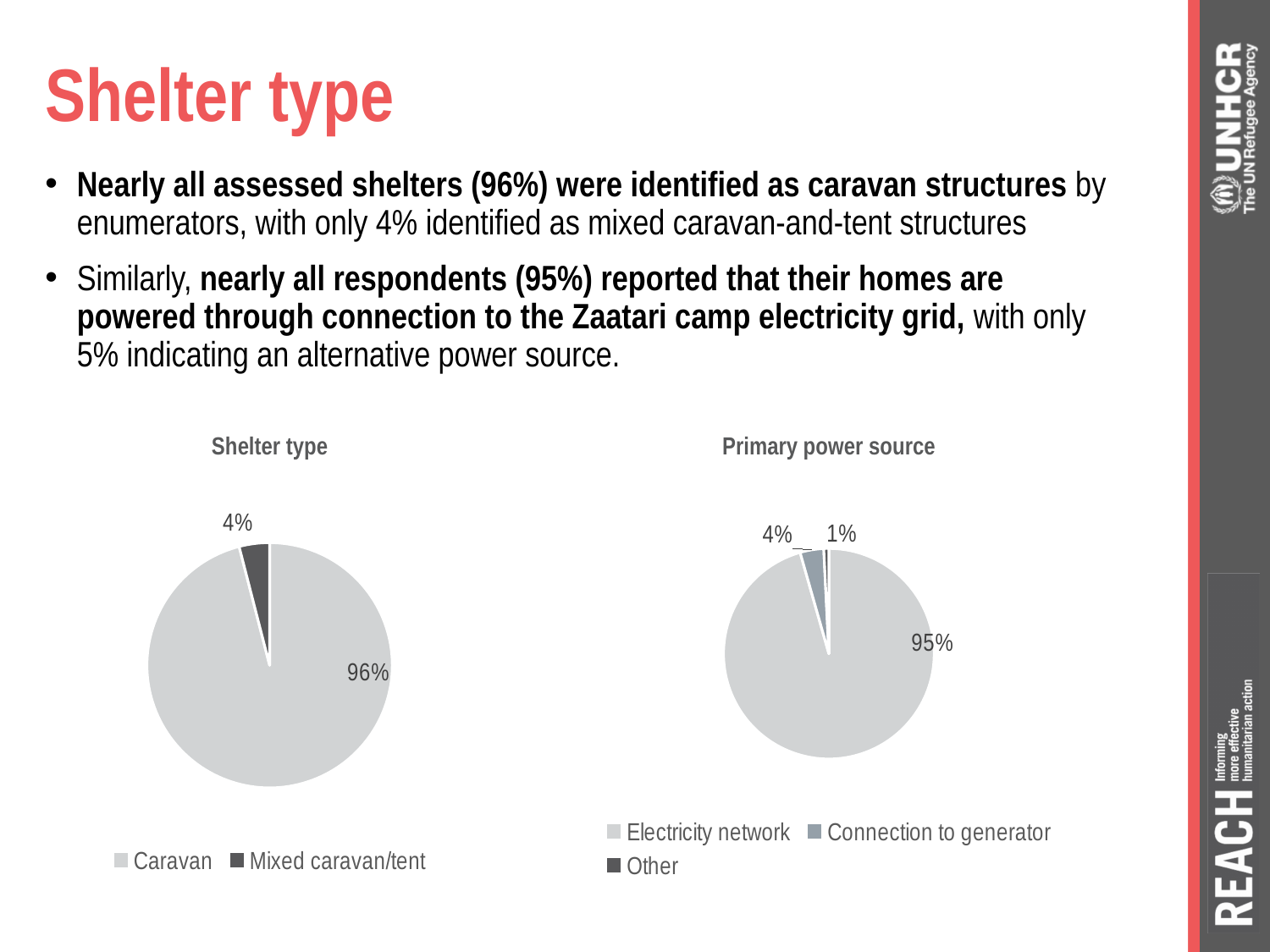
What kind of chart is the 'Shelter type' chart? Pie chart In the 'Shelter type' chart, what share of shelters are caravans? 96% In the 'Shelter type' chart, what share of shelters are mixed caravan/tent? 4% How many charts are shown on the slide? 2 How many categories does the legend of the 'Primary power source' chart list? 3 In the 'Primary power source' chart, what share of respondents use a connection to generator? 4% In the 'Shelter type' chart, which category has the largest share? Caravan In the 'Shelter type' chart, what is the difference in percentage points between the Caravan and Mixed caravan/tent shares? 92 In the 'Primary power source' chart, which category has the smallest share? Other In the 'Primary power source' chart, what share of respondents report 'Other' as their power source? 1% In the 'Primary power source' chart, which is larger: Connection to generator or Other? Connection to generator In the 'Primary power source' chart, what share of respondents use the electricity network? 95%